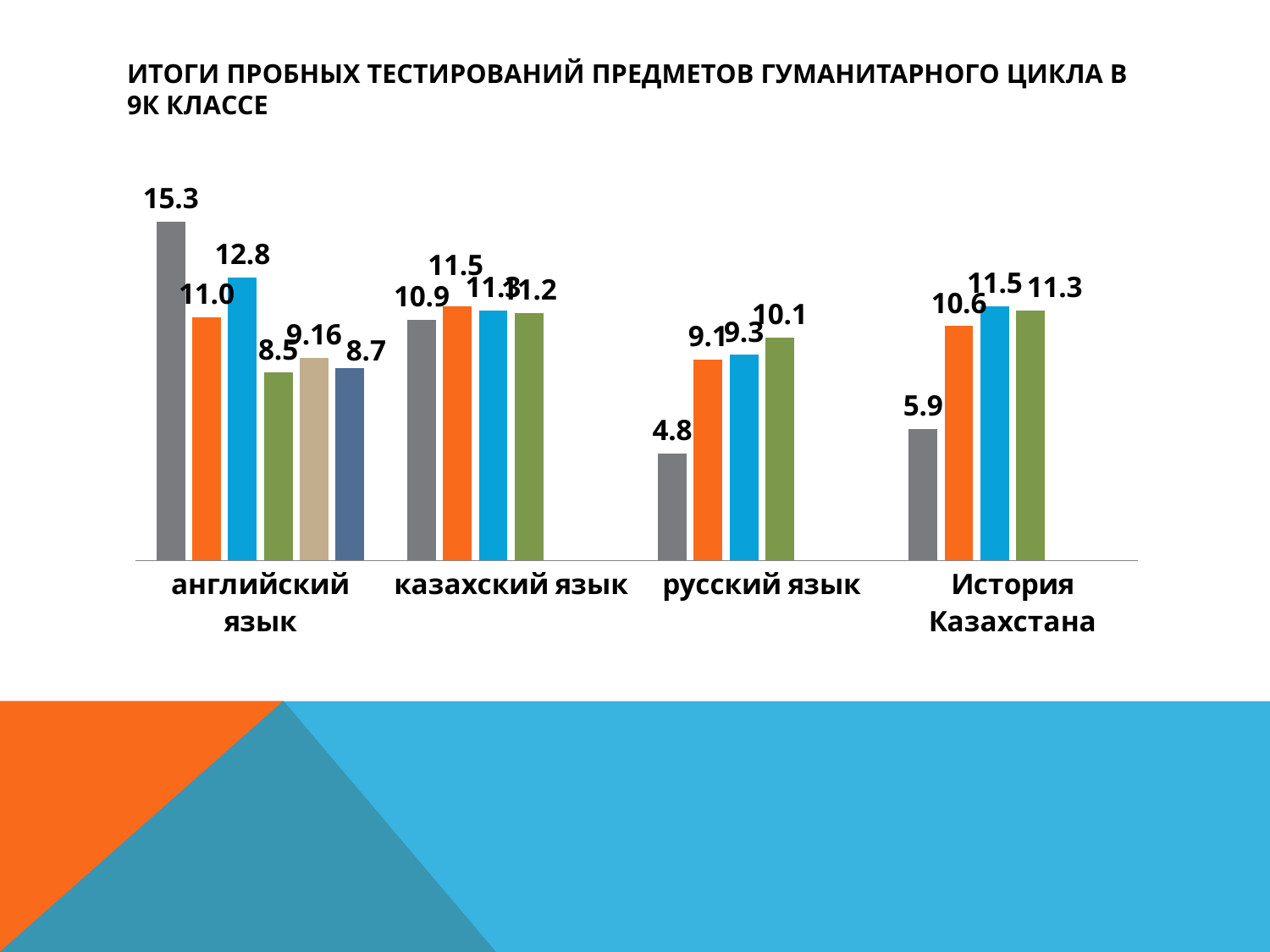
How many subject categories are shown on the x axis? 4 Which is larger: the light blue bar for английский язык or the light blue bar for История Казахстана? английский язык What is the value of the orange (second) bar for казахский язык? 11.5 What is the difference between the grey bar for английский язык (15.3) and the grey bar for русский язык (4.8)? 10.5 Which category has the lowest single bar value on the chart? русский язык What is the value of the green (last) bar for русский язык? 10.1 What is the value of the grey (first) bar for История Казахстана? 5.9 What is the value of the grey (first) bar for русский язык? 4.8 Which category has the highest single bar value on the chart? английский язык How many bars are shown for английский язык? 6 What is the value of the grey (first) bar for английский язык? 15.3 What type of chart is shown on the slide? bar chart